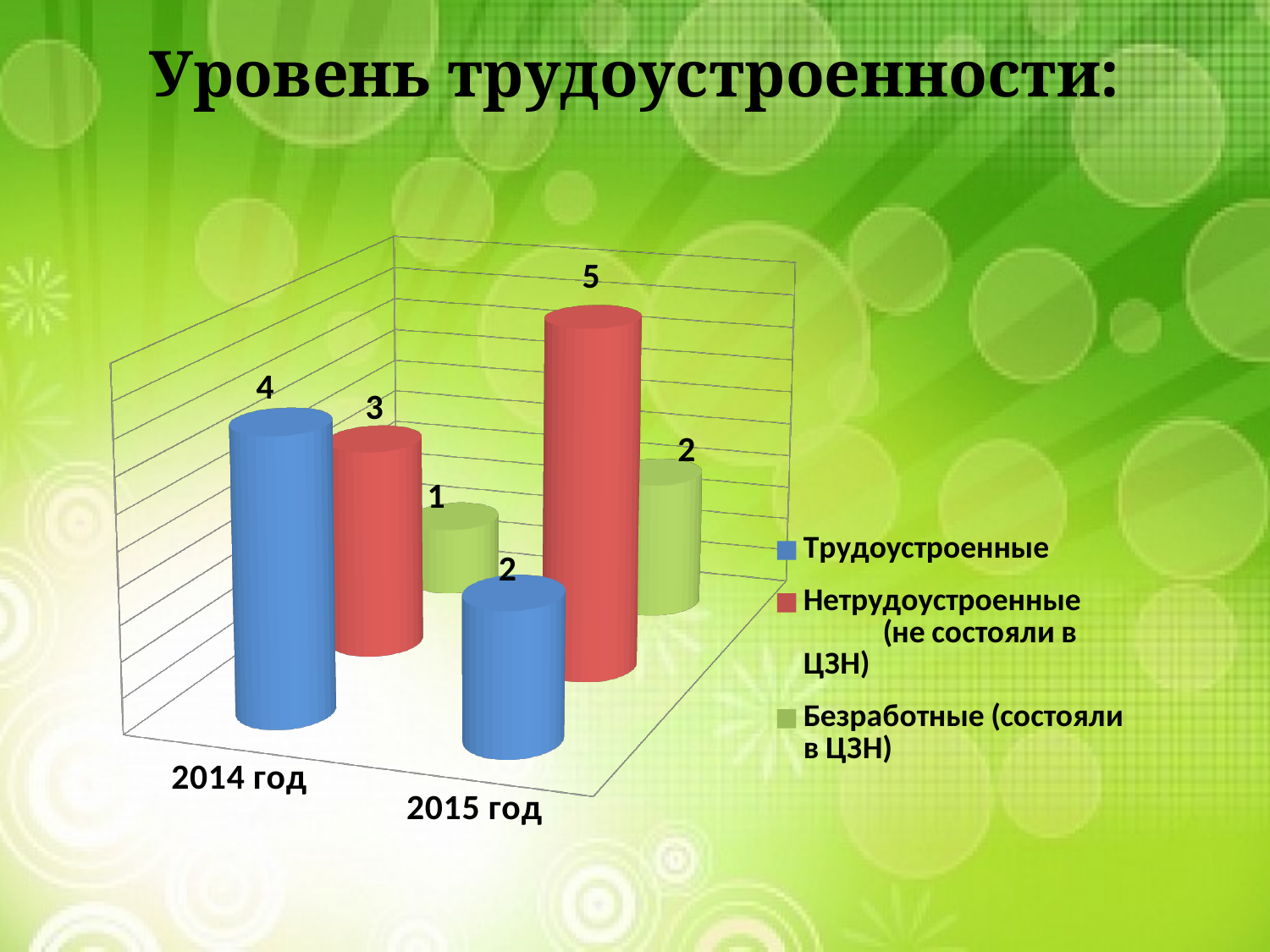
Which series has the lowest value in 2014 год? Безработные (состояли в ЦЗН) Which series has the highest value in 2015 год? Нетрудоустроенные (не состояли в ЦЗН) How many year categories are shown on the x axis? 2 What is the title of the slide? Уровень трудоустроенности: What is the value for Трудоустроенные in 2015 год? 2 Which is larger: Трудоустроенные in 2014 год or Трудоустроенные in 2015 год? 2014 год What is the value for Нетрудоустроенные (не состояли в ЦЗН) in 2015 год? 5 What is the value for Безработные (состояли в ЦЗН) in 2014 год? 1 What is the value for Трудоустроенные in 2014 год? 4 What is the difference between the Нетрудоустроенные (не состояли в ЦЗН) values for 2015 год and 2014 год? 2 What kind of chart is shown on the slide? Bar chart How many series does the legend list? 3